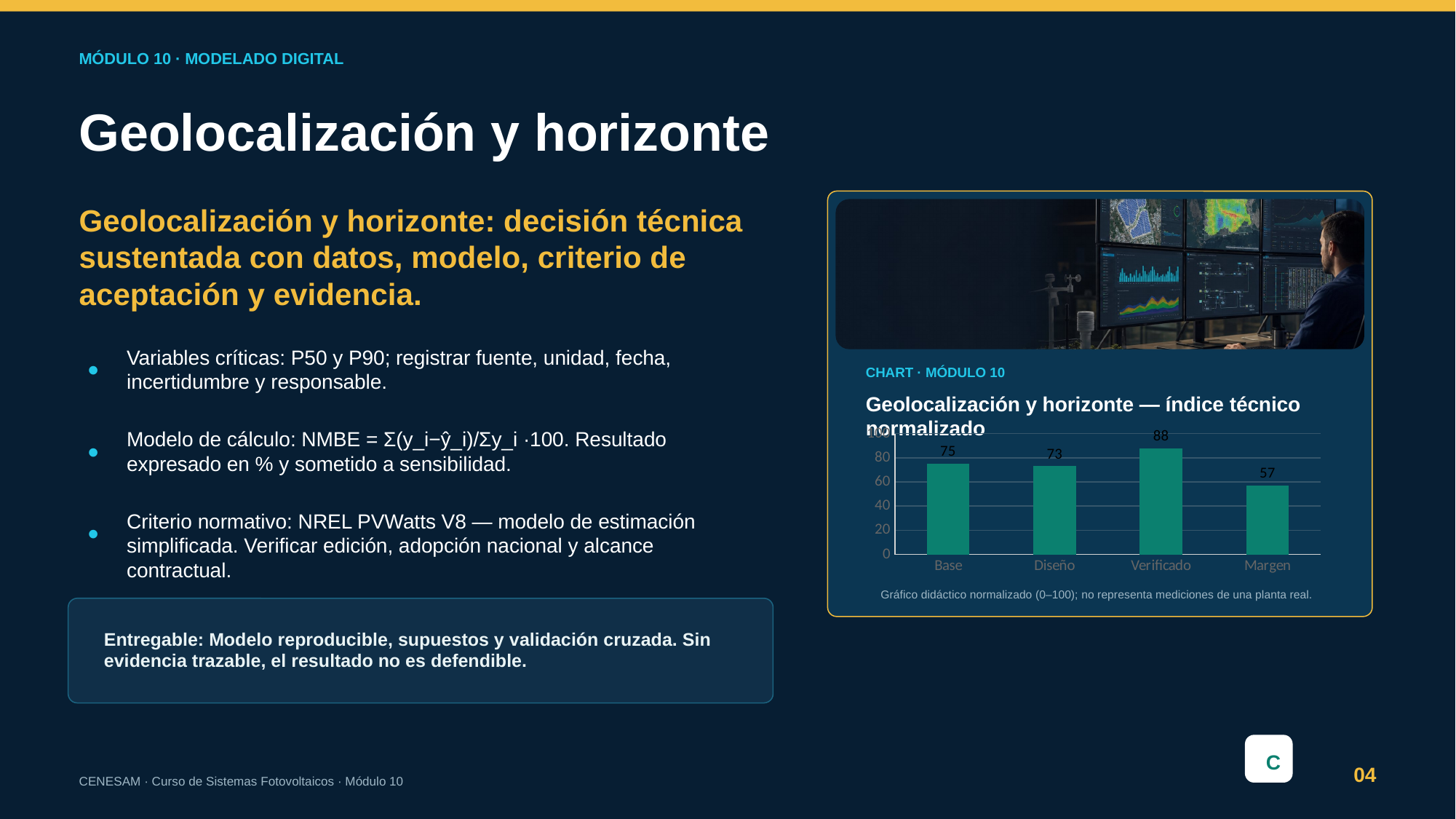
What is the title of the chart? Geolocalización y horizonte — índice técnico normalizado Which category has the highest value? Verificado What is the difference between the values for Verificado and Margen? 31 Which category has the lowest value? Margen What is the value for Margen? 57 What kind of chart is shown? bar chart What is the value for Diseño? 73 What is the value for Verificado? 88 Which is larger, the value for Base or the value for Margen? Base How many categories are shown on the x axis? 4 What is the value for Base? 75 Is the value for Margen greater or less than 60? less